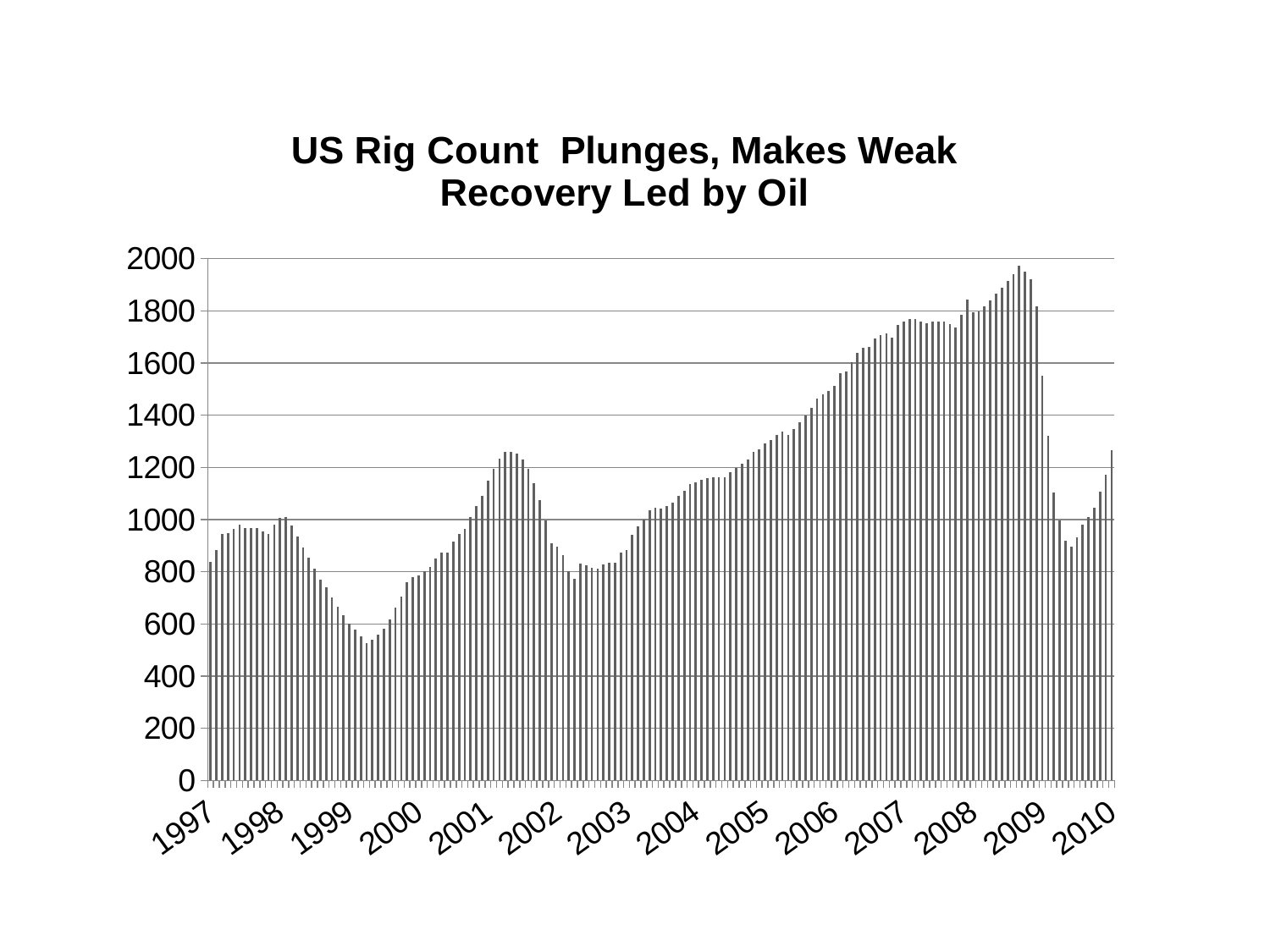
How many year labels are shown along the x axis? 14 Is the rig count at the start of 1999 greater or less than 800? less Is the rig count at the start of 2010 greater or less than 1000? greater What is the title of the chart? US Rig Count Plunges, Makes Weak Recovery Led by Oil Which is higher, the peak rig count around 2001 or the peak around 2008? 2008 Does the rig count rise or fall between 2003 and 2008? rise What kind of chart is shown on the slide? bar chart Is the rig count at the start of 2003 greater or less than 1000? less What is the highest value shown on the vertical axis? 2000 In which year does the rig count reach its lowest point? 1999 In which year does the rig count reach its highest peak? 2008